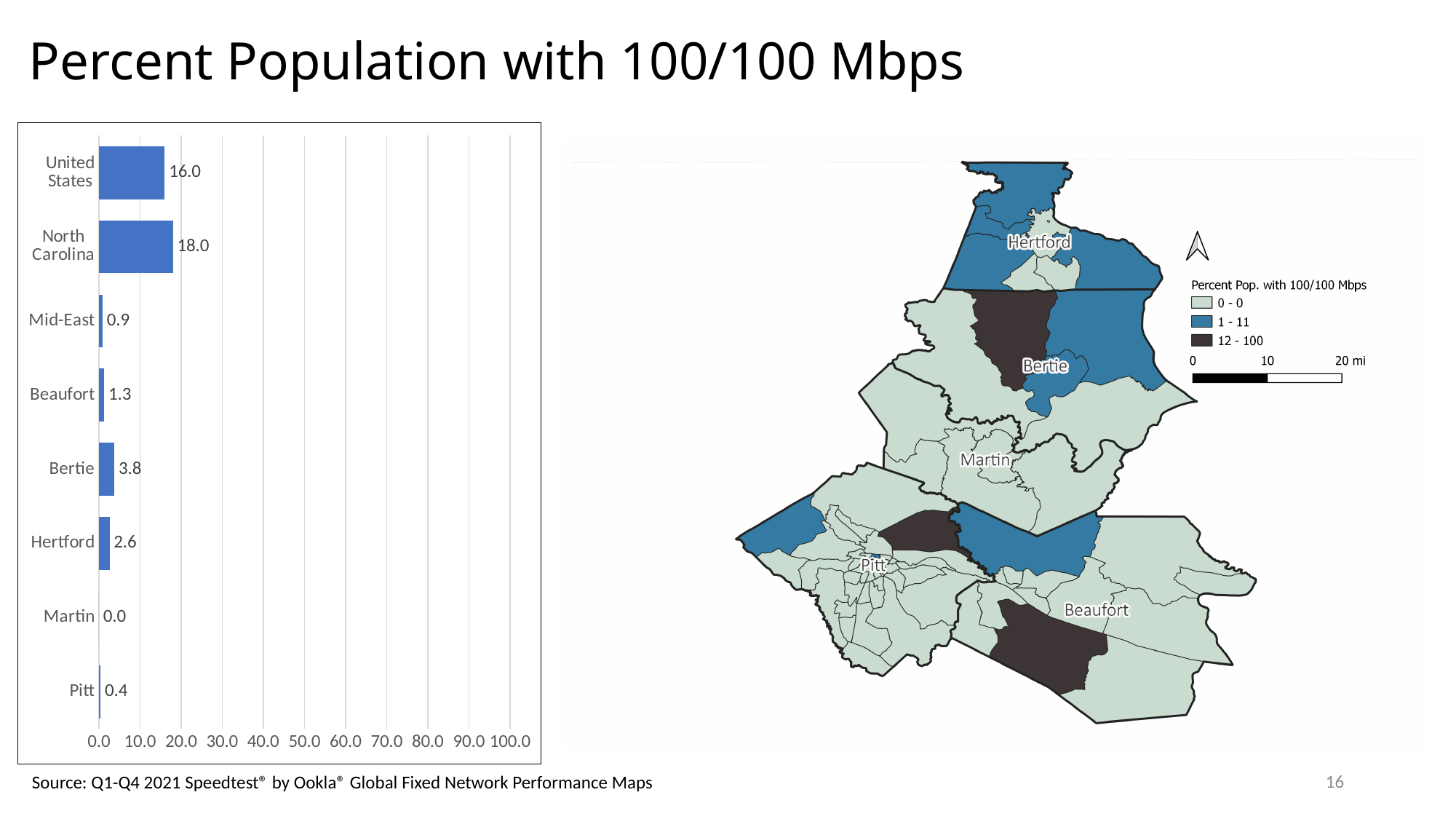
Which category has the highest value in the bar chart? North Carolina What is the value for Hertford in the bar chart? 2.6 Which is larger in the bar chart, the value for Bertie or the value for Beaufort? Bertie What is the difference between the values for North Carolina and United States in the bar chart? 2.0 How many categories are shown in the bar chart? 8 Which category has the lowest value in the bar chart? Martin What is the value for Pitt in the bar chart? 0.4 What is the value for North Carolina in the bar chart? 18.0 What kind of chart is shown on the left of the slide? Bar chart What is the value for Bertie in the bar chart? 3.8 Is the value for United States in the bar chart greater or less than 10.0? greater What is the title of the slide containing the bar chart? Percent Population with 100/100 Mbps